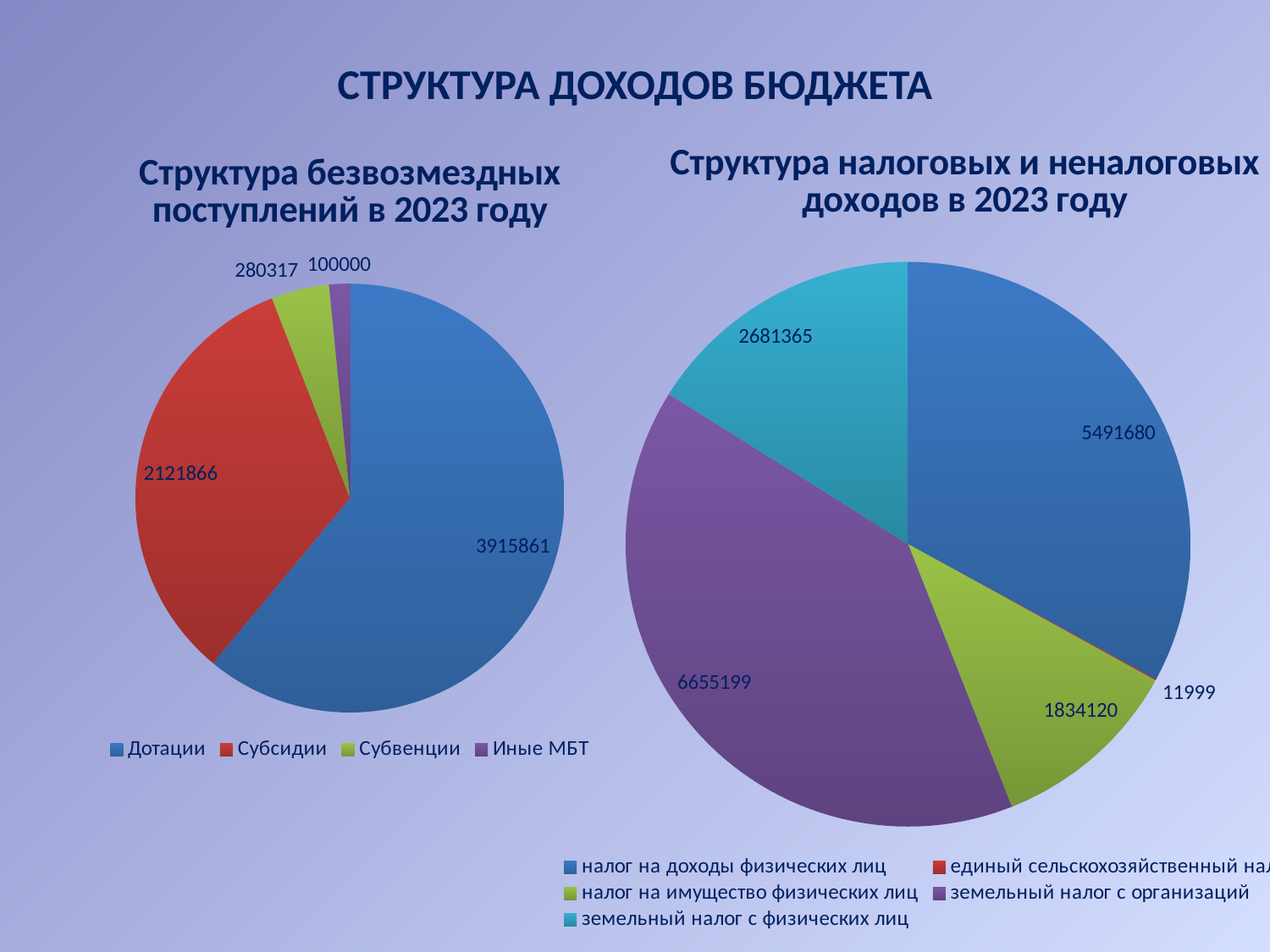
In the left chart 'Структура безвозмездных поступлений в 2023 году', what is the value for Дотации? 3915861 In the left chart 'Структура безвозмездных поступлений в 2023 году', which category has the smallest slice? Иные МБТ In the left chart 'Структура безвозмездных поступлений в 2023 году', what is the value for Субвенции? 280317 In the right chart 'Структура налоговых и неналоговых доходов в 2023 году', which is larger: налог на доходы физических лиц or земельный налог с физических лиц? налог на доходы физических лиц In the left chart 'Структура безвозмездных поступлений в 2023 году', which category has the largest slice? Дотации What type of chart is used for 'Структура налоговых и неналоговых доходов в 2023 году'? Pie chart In the right chart 'Структура налоговых и неналоговых доходов в 2023 году', what is the difference between земельный налог с организаций and налог на доходы физических лиц? 1163519 In the right chart 'Структура налоговых и неналоговых доходов в 2023 году', what is the value for налог на имущество физических лиц? 1834120 In the right chart 'Структура налоговых и неналоговых доходов в 2023 году', what is the value for земельный налог с организаций? 6655199 In the left chart 'Структура безвозмездных поступлений в 2023 году', what is the difference between Дотации and Субсидии? 1793995 In the right chart 'Структура налоговых и неналоговых доходов в 2023 году', which category has the largest slice? земельный налог с организаций How many categories does the legend of the left chart 'Структура безвозмездных поступлений в 2023 году' list? 4